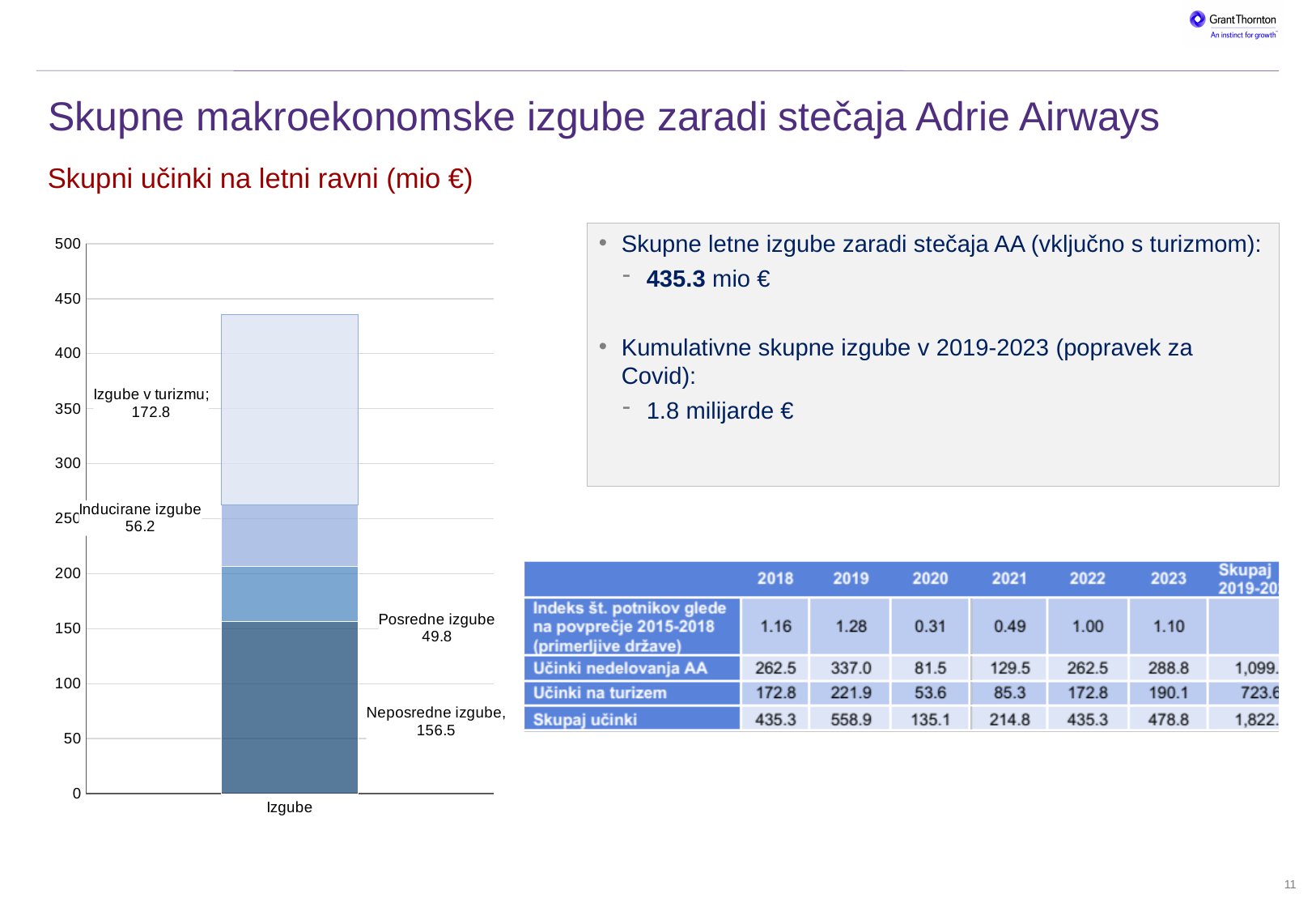
What kind of chart is shown on the left of the slide? Stacked bar chart Which segment of the stacked bar has the smallest value? Posredne izgube What is the value of the "Neposredne izgube" segment in the stacked bar? 156.5 How many segments make up the stacked bar? 4 Which is larger, the "Inducirane izgube" segment or the "Posredne izgube" segment? Inducirane izgube Is the total height of the stacked bar greater or less than 400? greater Which segment of the stacked bar has the largest value? Izgube v turizmu What is the difference between the "Izgube v turizmu" and "Neposredne izgube" segments? 16.3 What is the total of the stacked bar "Izgube"? 435.3 What is the value of the "Posredne izgube" segment in the stacked bar? 49.8 What is the value of the "Inducirane izgube" segment in the stacked bar? 56.2 What is the value of the "Izgube v turizmu" segment in the stacked bar? 172.8